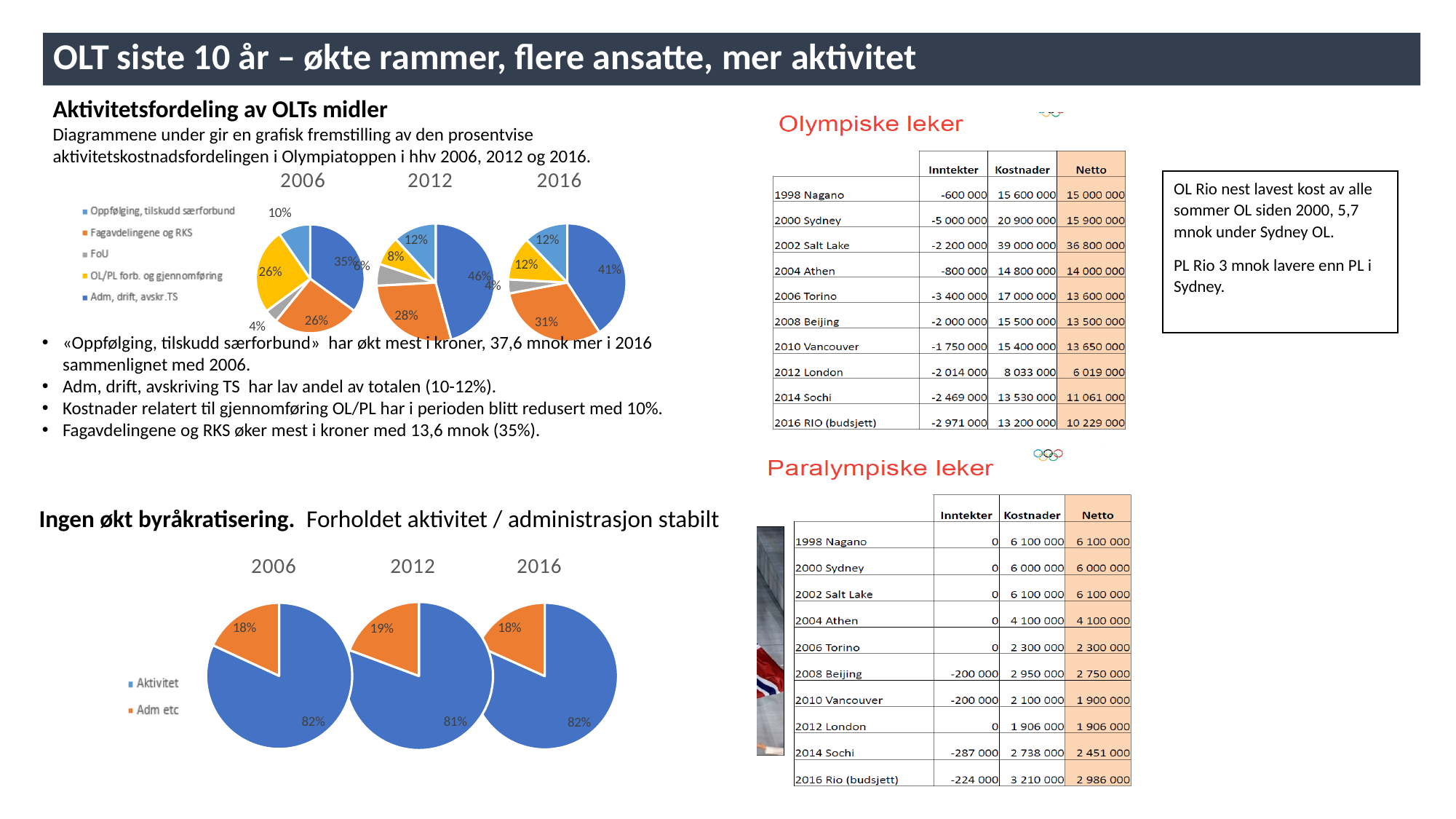
In the top-left chart (Aktivitetsfordeling av OLTs midler), which category has the largest slice in the 2016 pie? Oppfølging, tilskudd særforbund In the top-left chart (Aktivitetsfordeling av OLTs midler), how many entries does the legend list? 5 What kind of chart is used in the bottom-left chart (Ingen økt byråkratisering)? Pie chart In the bottom-left chart (Ingen økt byråkratisering), what share does 'Adm etc' have in the 2016 pie? 18% In the top-left chart (Aktivitetsfordeling av OLTs midler), what share does 'Adm, drift, avskr.TS' have in the 2016 pie? 12% In the bottom-left chart (Ingen økt byråkratisering), how many entries does the legend list? 2 In the bottom-left chart (Ingen økt byråkratisering), what share does 'Adm etc' have in the 2006 pie? 18% In the bottom-left chart (Ingen økt byråkratisering), which is larger in the 2012 pie, 'Aktivitet' or 'Adm etc'? Aktivitet In the top-left chart (Aktivitetsfordeling av OLTs midler), how many pie charts are shown? 3